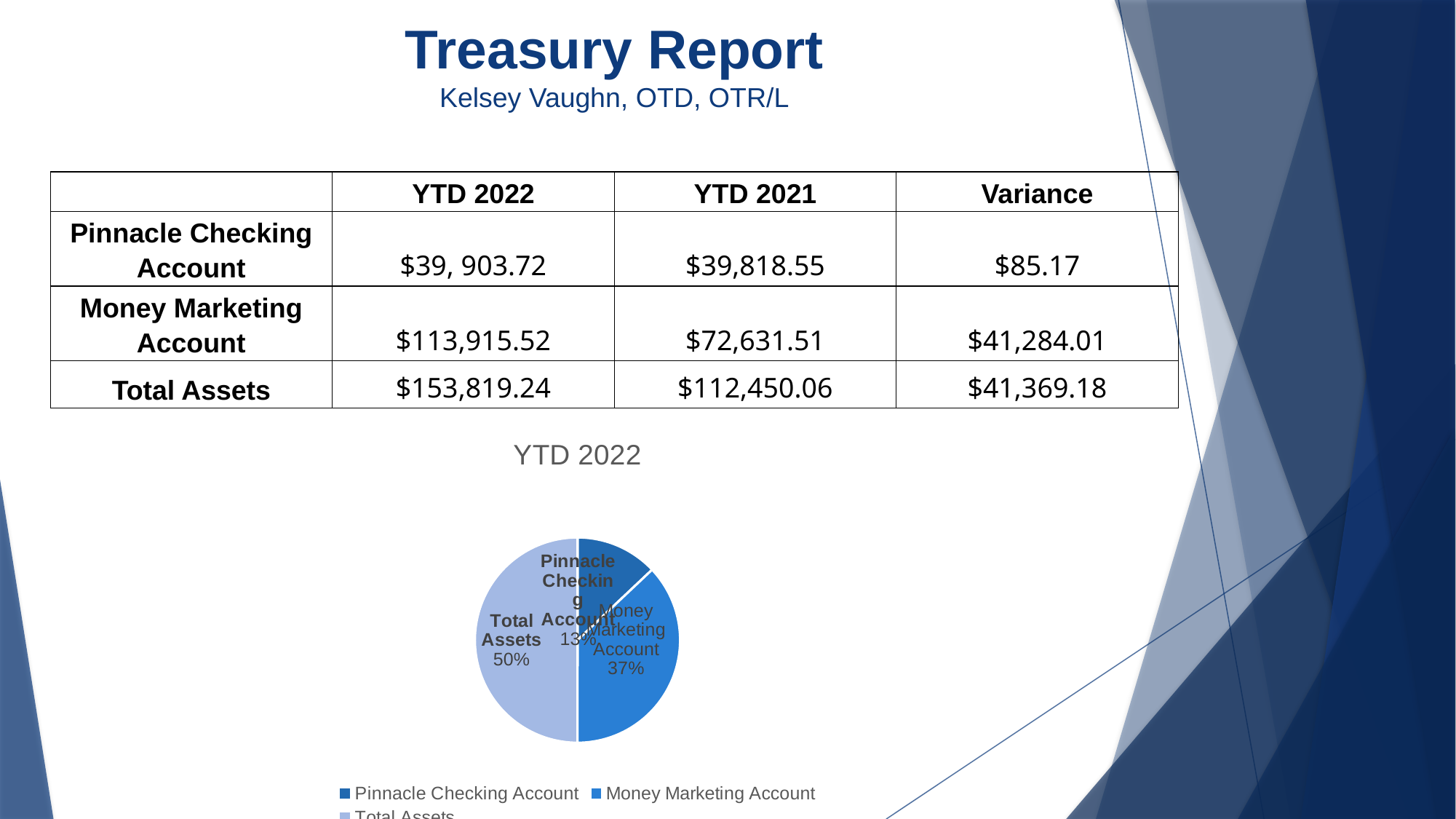
In the pie chart, which is larger: the Money Marketing Account slice or the Pinnacle Checking Account slice? Money Marketing Account In the pie chart, what share is labelled for Total Assets? 50% In the pie chart, what is the difference in percentage points between the Money Marketing Account slice and the Pinnacle Checking Account slice? 24 What kind of chart is shown under the heading "YTD 2022"? pie chart How many slices does the pie chart have? 3 Which slice of the pie chart is the smallest? Pinnacle Checking Account Which slice of the pie chart is the largest? Total Assets How many entries does the pie chart's legend list? 3 In the pie chart, what is the difference in percentage points between the Total Assets slice and the Money Marketing Account slice? 13 In the pie chart, what share is labelled for Money Marketing Account? 37% In the pie chart, what share is labelled for Pinnacle Checking Account? 13% What is the title of the pie chart? YTD 2022